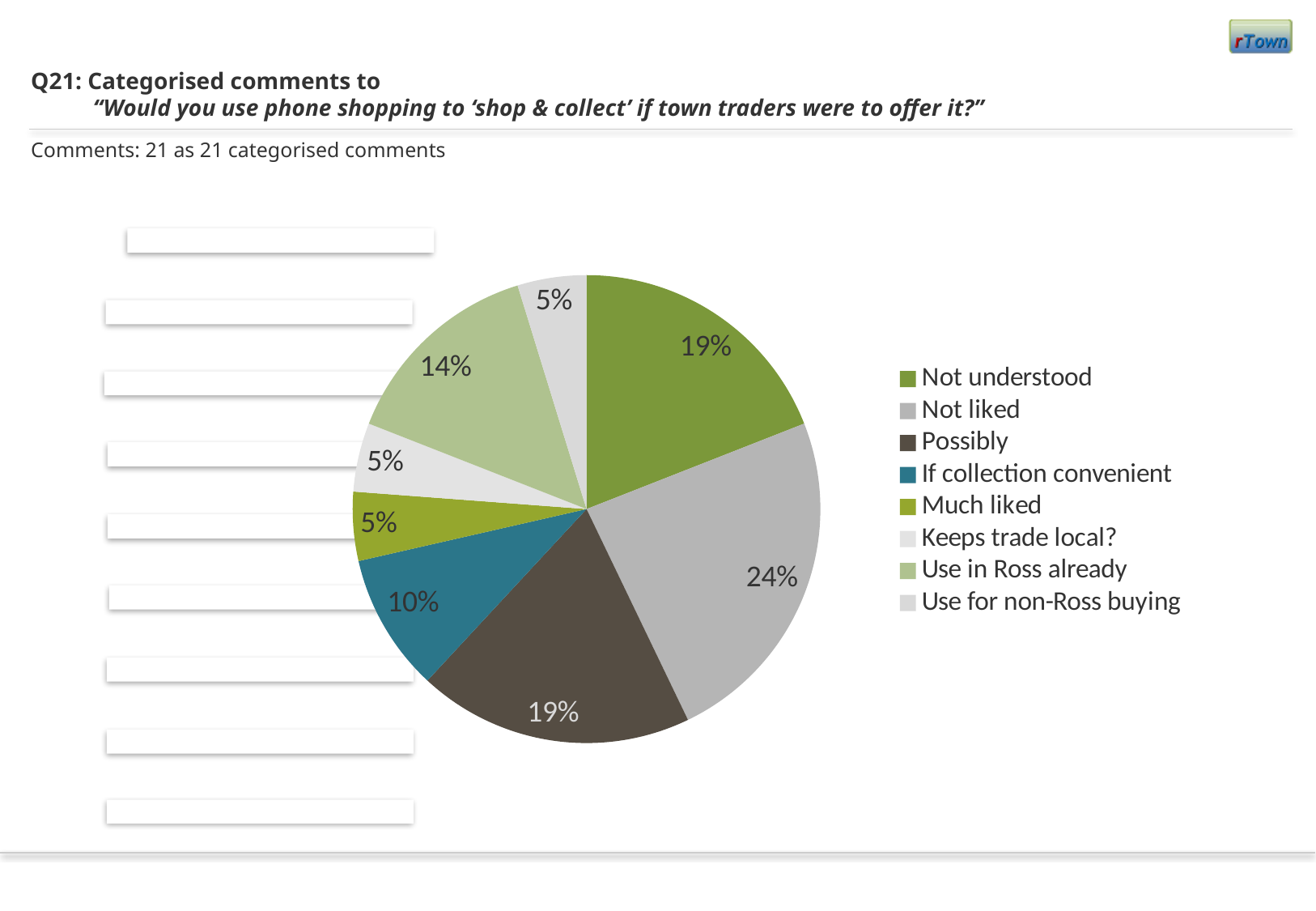
What is the difference in percentage points between 'Use in Ross already' and 'If collection convenient'? 4 Which is larger: the slice for 'Not liked' or the slice for 'Possibly'? Not liked What share of comments is labelled 'Not liked'? 24% What share of comments is labelled 'Use in Ross already'? 14% What share of comments is labelled 'If collection convenient'? 10% Which category has the largest slice of the pie? Not liked What kind of chart is shown on the slide? pie chart What share of comments is labelled 'Not understood'? 19% How many categories does the legend list? 8 What share of comments is labelled 'Much liked'? 5% What is the difference in percentage points between 'Not liked' and 'Not understood'? 5 How many categorised comments does the slide say the chart is based on? 21